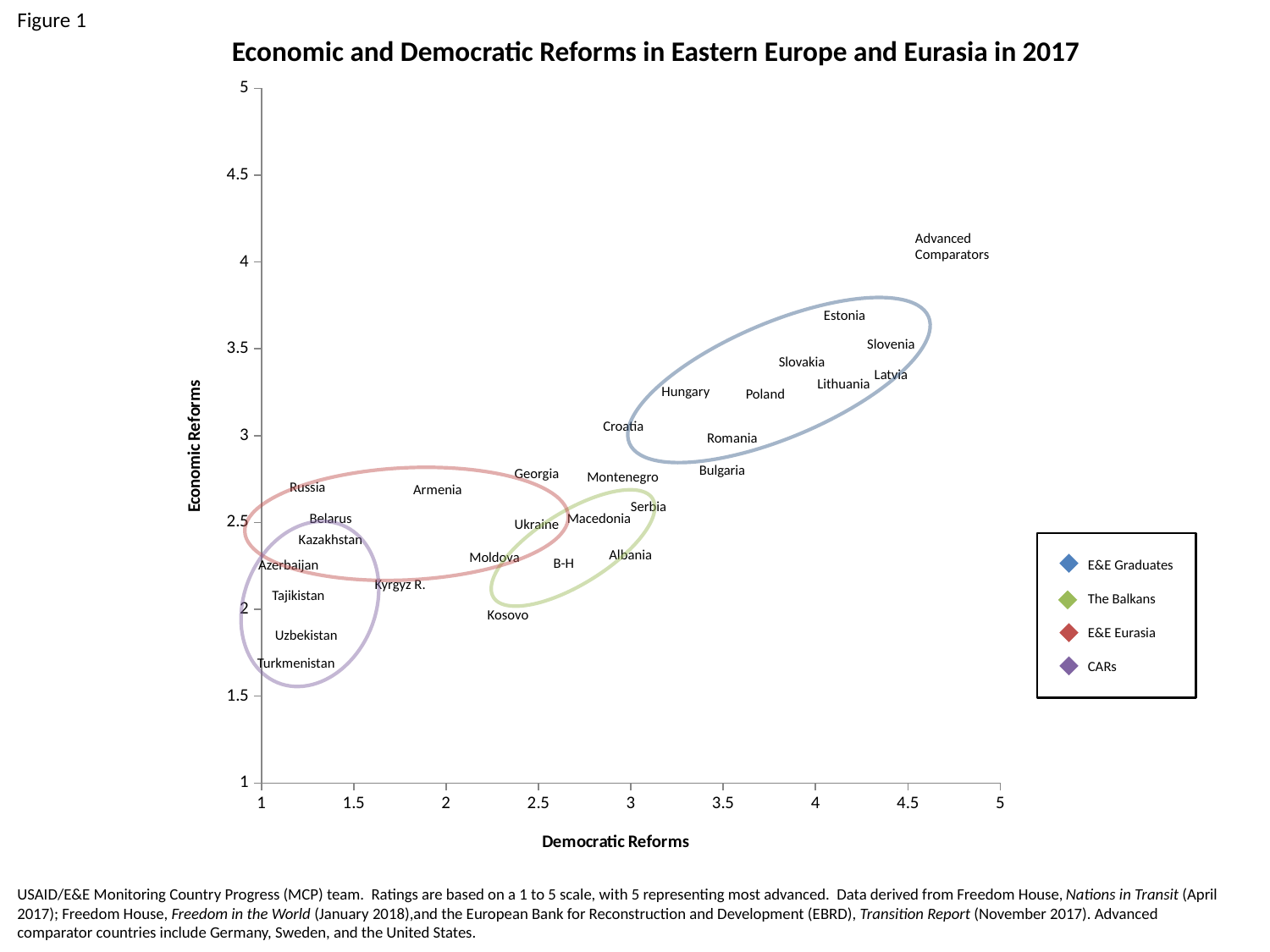
What is the label of the horizontal axis? Democratic Reforms What kind of chart is shown on the slide? Scatter chart Do Economic Reforms values generally rise or fall as Democratic Reforms increase along the x axis? rise Which has the higher Economic Reforms value, Estonia or Turkmenistan? Estonia Is the Democratic Reforms value for Russia greater or less than 1.5? less Which has the higher Democratic Reforms value, Slovenia or Russia? Slovenia What is the title of the chart? Economic and Democratic Reforms in Eastern Europe and Eurasia in 2017 Is the Economic Reforms value for Estonia greater or less than 3.5? greater Which labelled point has the highest Economic Reforms value? Advanced Comparators How many groups does the legend list? 4 Is the Economic Reforms value for Turkmenistan greater or less than 2? less